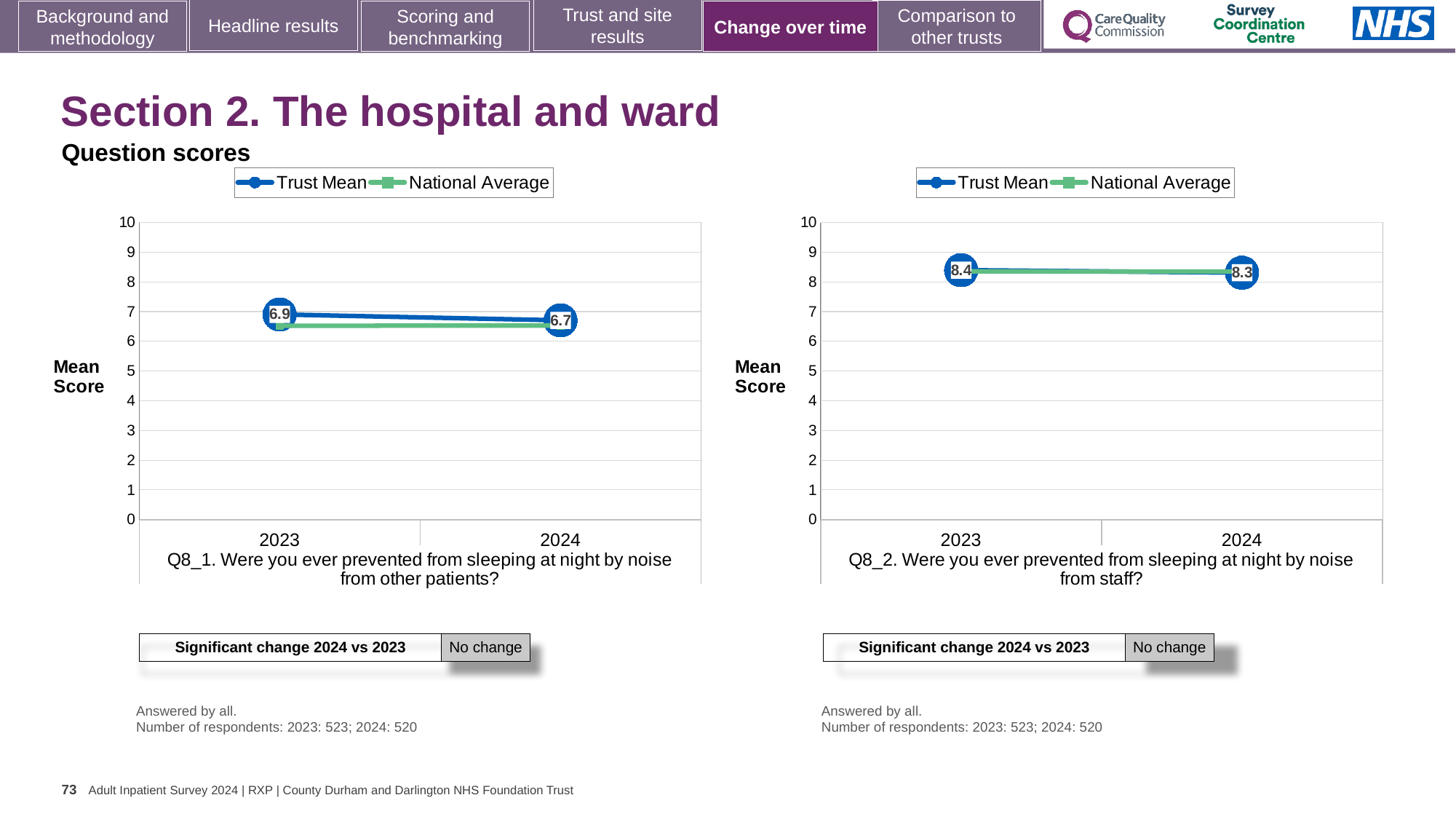
How many series does the legend of the Q8_1 chart (left) list? 2 In the Q8_1 chart (left), what is the Trust Mean score for 2023? 6.9 In the Q8_1 chart (left), by how much did the Trust Mean change from 2023 to 2024? 0.2 In the Q8_2 chart (right), what is the Trust Mean score for 2024? 8.3 In the Q8_2 chart (right), what is the Trust Mean score for 2023? 8.4 In the Q8_2 chart (right), what is the difference between the Trust Mean in 2023 and 2024? 0.1 What does the 'Significant change 2024 vs 2023' box below the Q8_2 chart (right) say? No change In the Q8_1 chart (left), what is the Trust Mean score for 2024? 6.7 What kind of chart is the Q8_2 chart (right)? line chart In the Q8_1 chart (left), does the Trust Mean rise or fall from 2023 to 2024? fall How many years are plotted on the x axis of the Q8_2 chart (right)? 2 In the Q8_1 chart (left), is the National Average for 2024 greater or less than 7? less